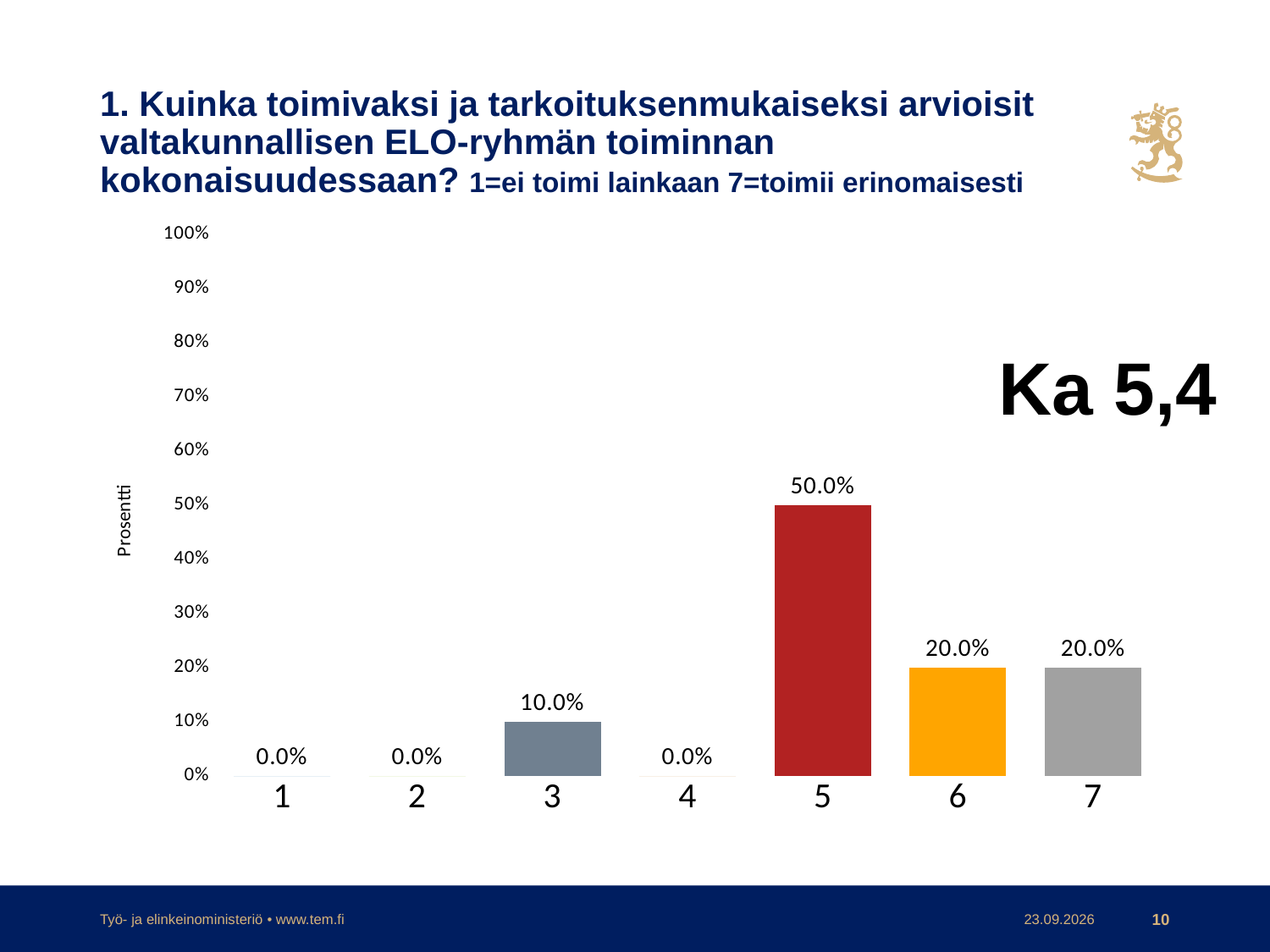
How many categories are shown on the x axis? 7 What is the difference between the values for category 5 and category 7? 30.0% What is the value for category 6? 20.0% What is the value for category 3? 10.0% What is the difference between the values for category 6 and category 3? 10.0% What is the label of the y axis? Prosentti Which is larger, the value for category 3 or the value for category 7? 7 What is the value for category 1? 0.0% Which category has the highest value? 5 What kind of chart is shown on the slide? bar chart Is the value for category 5 greater or less than 40%? greater What is the value for category 5? 50.0%